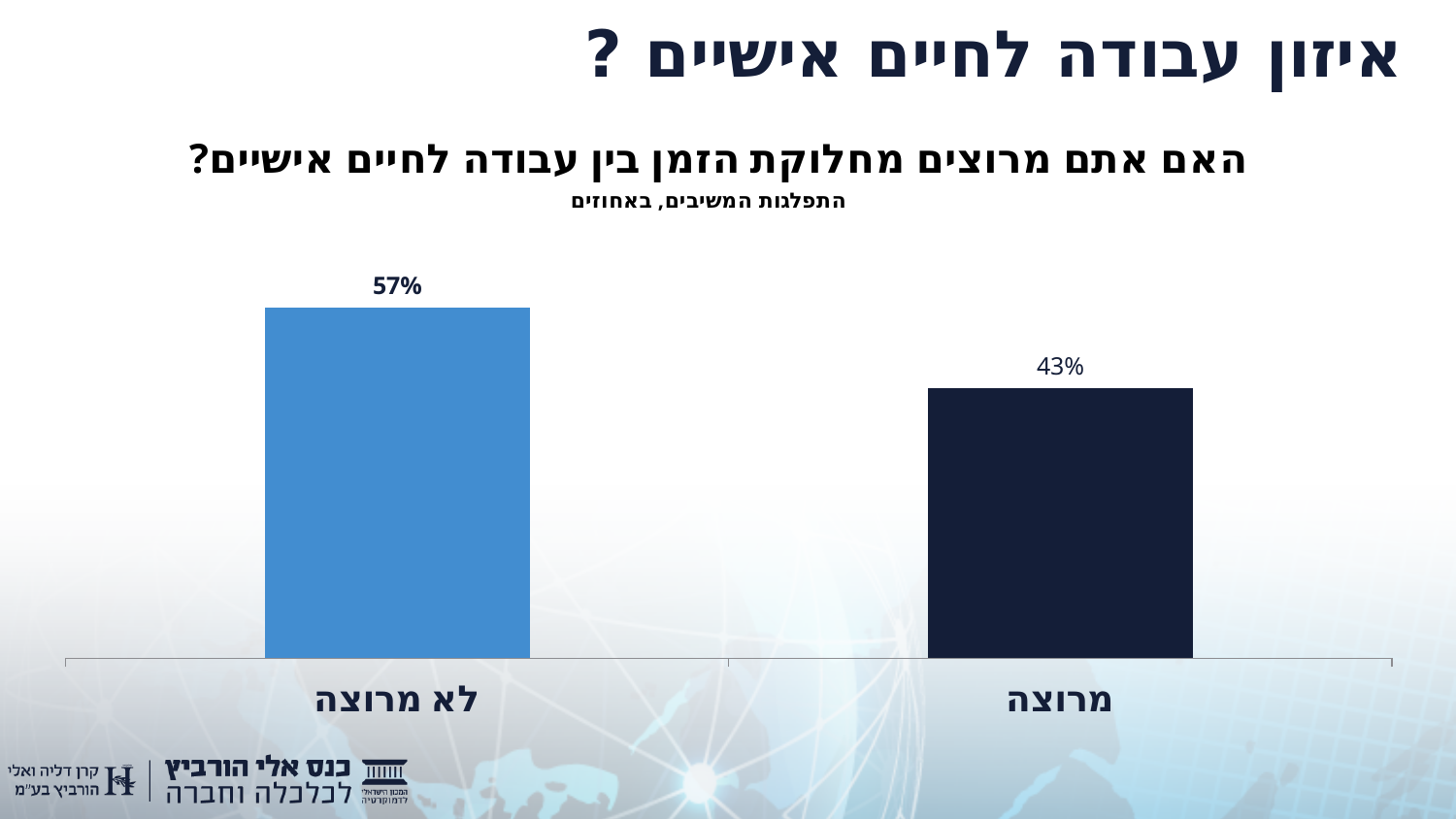
What is the difference between the "לא מרוצה" and "מרוצה" values? 14% How many categories are shown in the chart? 2 Which is larger, the value for "מרוצה" or the value for "לא מרוצה"? לא מרוצה What kind of chart is shown on the slide? Bar chart Which category has the highest value? לא מרוצה What is the title of the chart? האם אתם מרוצים מחלוקת הזמן בין עבודה לחיים אישיים? Which category has the lowest value? מרוצה What percentage is shown for the "מרוצה" bar? 43% What colour is the "מרוצה" bar? Dark navy What is the total of the two bar values? 100% What percentage is shown for the "לא מרוצה" bar? 57%